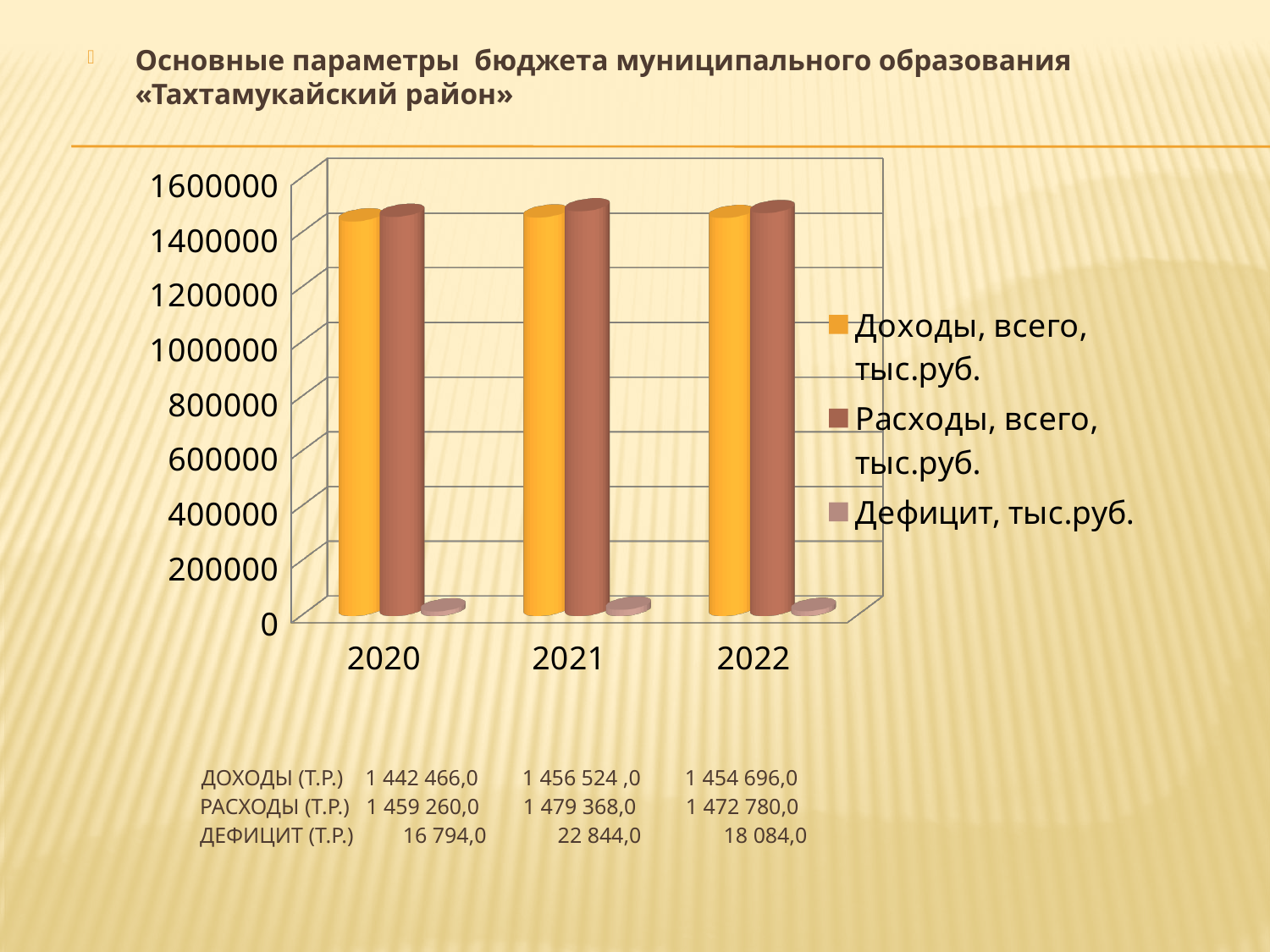
How many years are shown on the x axis of the chart? 3 How many series does the chart legend list? 3 Which is larger in 2022, Доходы or Расходы? Расходы What is the value of Расходы (т.р.) for 2021? 1 479 368,0 What is the value of Дефицит (т.р.) for 2022? 18 084,0 Is the value for Доходы in 2020 greater or less than 1400000? greater In which year is Дефицит (т.р.) the highest? 2021 By how much did Дефицит (т.р.) change from 2020 to 2021? 6 050,0 What is the value of Доходы (т.р.) for 2020? 1 442 466,0 What kind of chart is shown on the slide? Bar chart What is the difference between Расходы and Доходы in 2021? 22 844,0 In which year is Доходы (т.р.) the lowest? 2020